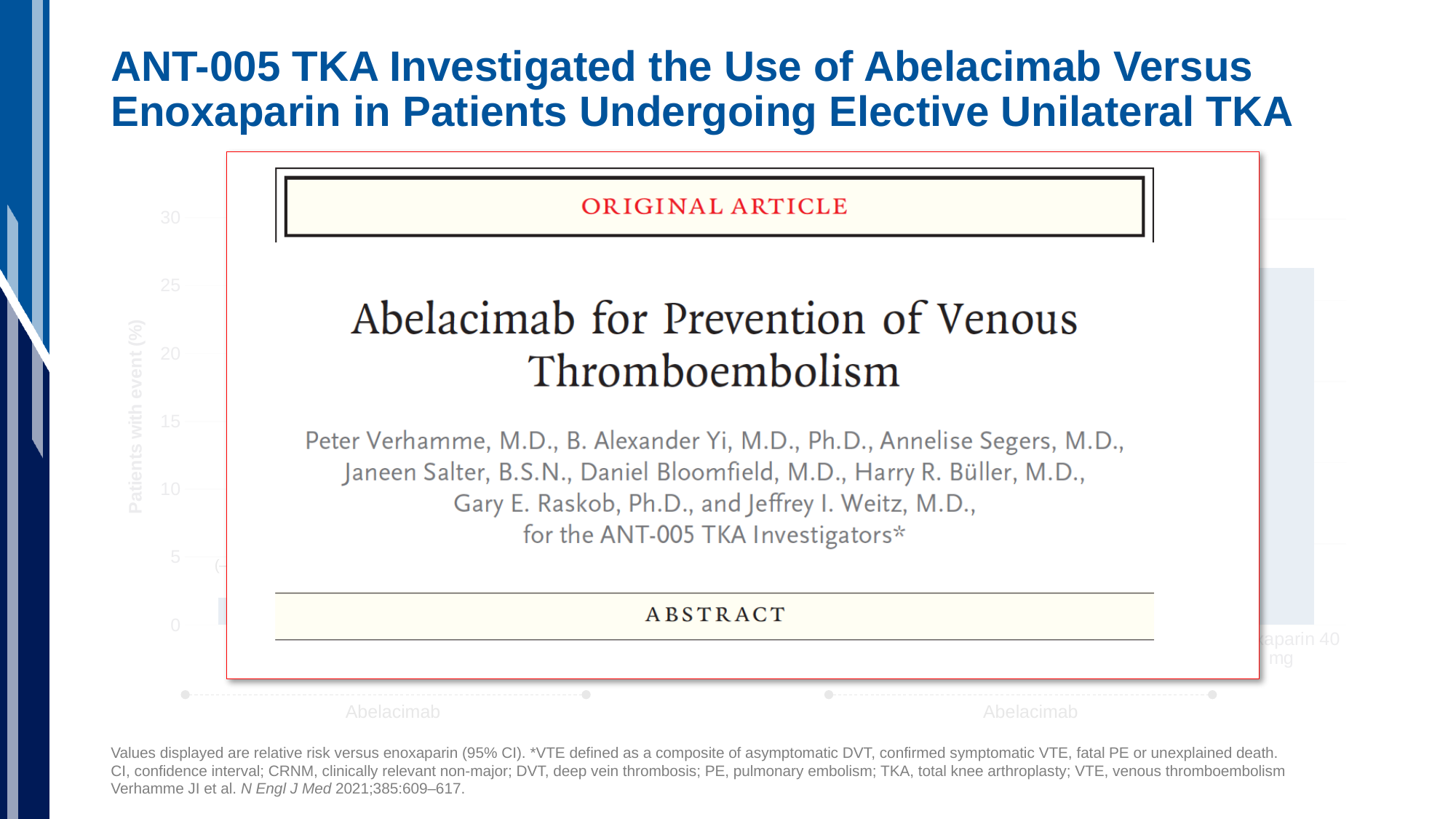
What kind of chart is shown on the slide behind the article image? bar chart Is the value of the rightmost bar (the enoxaparin 40 mg bar) greater or less than 20? greater What is the label on the y-axis of the chart? Patients with event (%) What is the highest tick value shown on the y-axis of the chart? 30